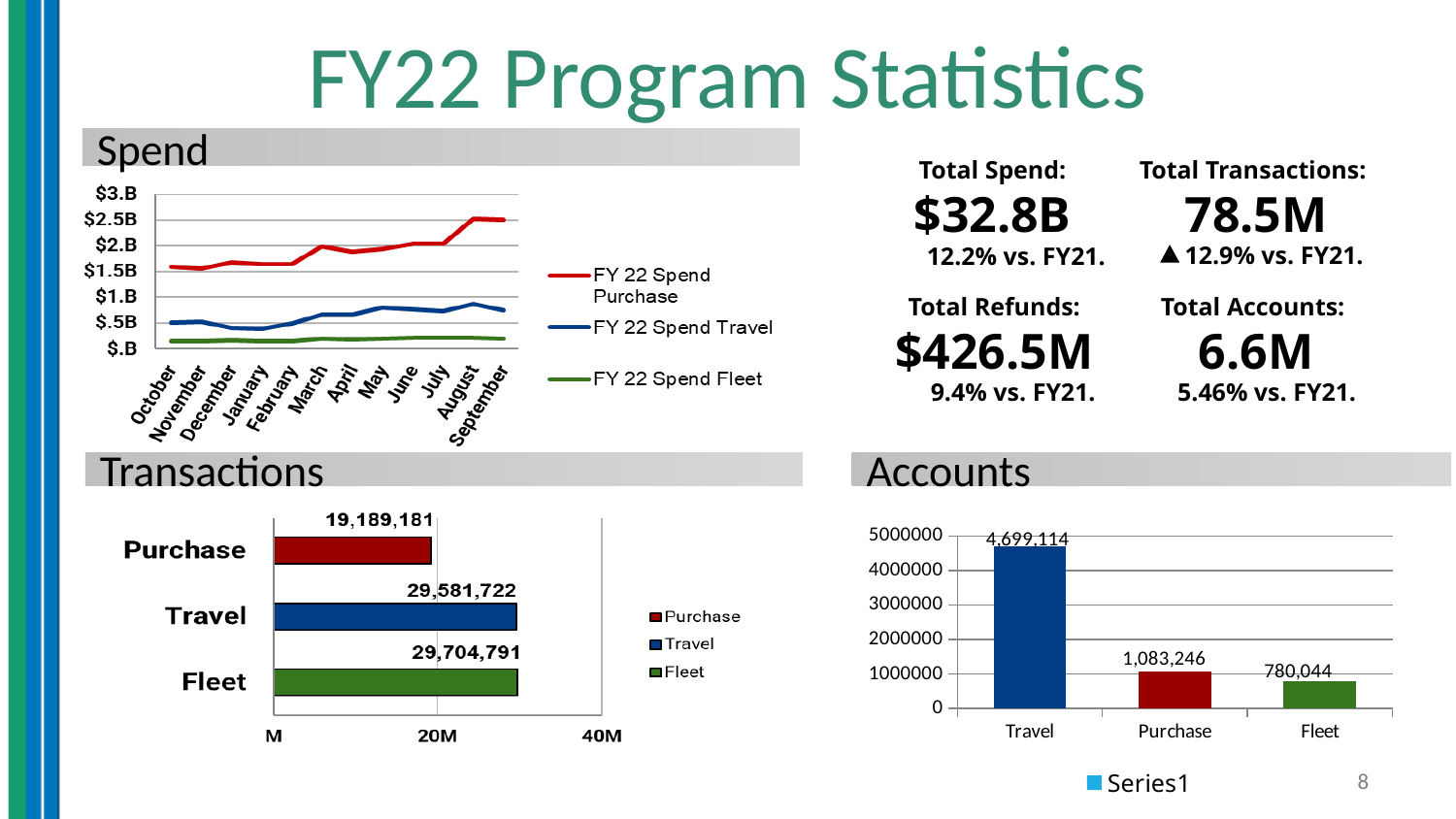
In the Transactions chart, what is the value for Purchase? 19,189,181 In the Accounts chart, which category has the highest value? Travel In the Transactions chart, which category has the lowest value? Purchase In the Accounts chart, is the value for Purchase greater or less than 1000000? greater In the Accounts chart, what is the value for Fleet? 780,044 In the Transactions chart, what is the difference between Travel and Purchase? 10,392,541 In the Accounts chart, what is the difference between Purchase and Fleet? 303,202 In the Transactions chart, what is the value for Fleet? 29,704,791 How many series does the legend of the Spend chart list? 3 What kind of chart is the Spend chart? line chart In the Spend chart, does FY 22 Spend Purchase generally rise or fall from October to September? rise In the Accounts chart, what is the value for Travel? 4,699,114